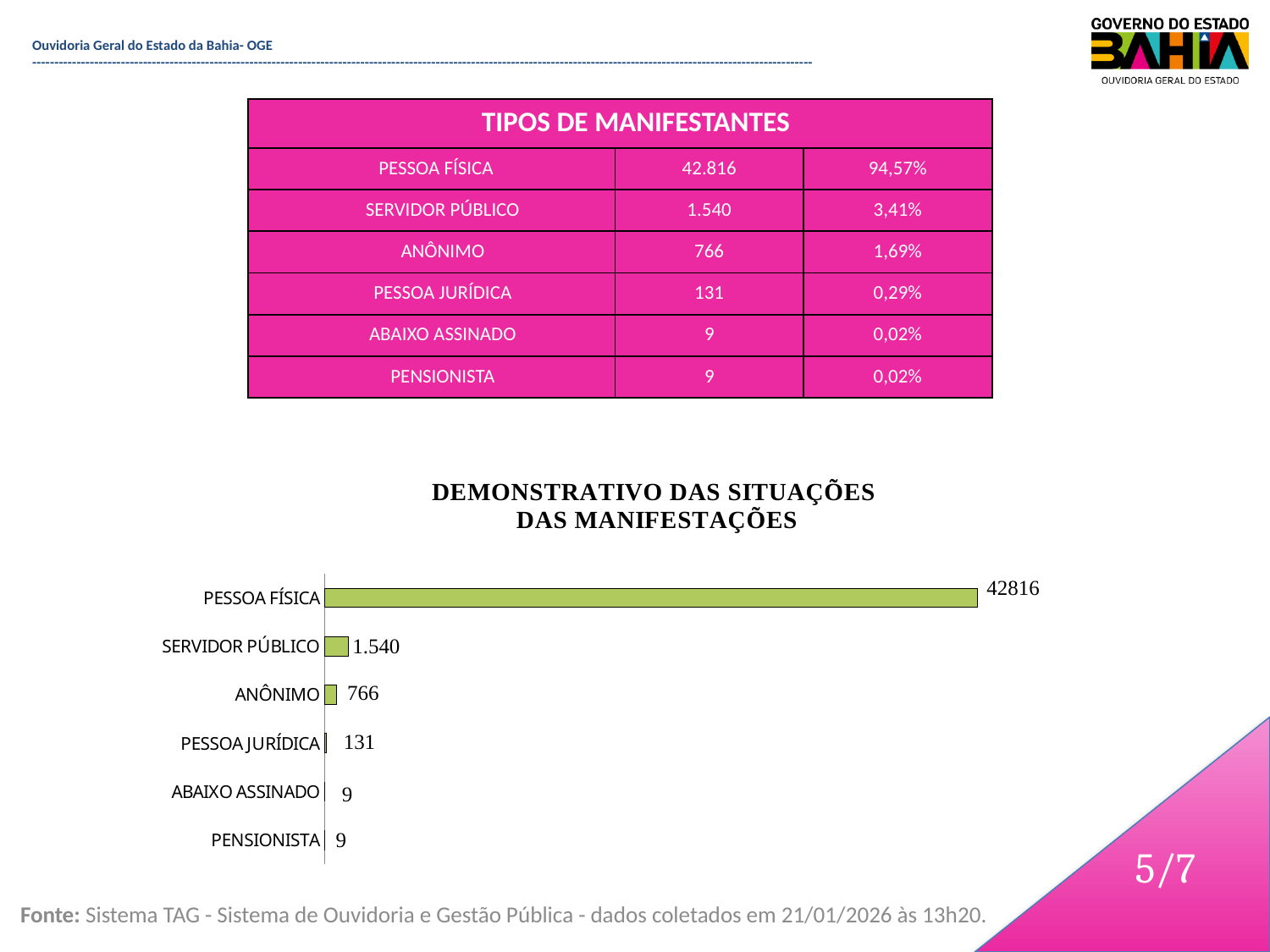
In the bar chart, how many categories are plotted? 6 In the bar chart, what is the value for PENSIONISTA? 9 In the bar chart, what is the value for ANÔNIMO? 766 In the bar chart, which is larger, the value for ANÔNIMO or the value for PESSOA JURÍDICA? ANÔNIMO What type of chart is shown under the title "DEMONSTRATIVO DAS SITUAÇÕES DAS MANIFESTAÇÕES"? bar chart In the bar chart, which category has the highest value? PESSOA FÍSICA What is the title of the bar chart on the slide? DEMONSTRATIVO DAS SITUAÇÕES DAS MANIFESTAÇÕES In the bar chart, what is the difference between the values for SERVIDOR PÚBLICO and ANÔNIMO? 774 In the bar chart, do the values increase or decrease going from the top category to the bottom category? decrease In the bar chart, what is the value for PESSOA JURÍDICA? 131 In the bar chart, what is the value for SERVIDOR PÚBLICO? 1.540 In the bar chart, what is the value for PESSOA FÍSICA? 42816